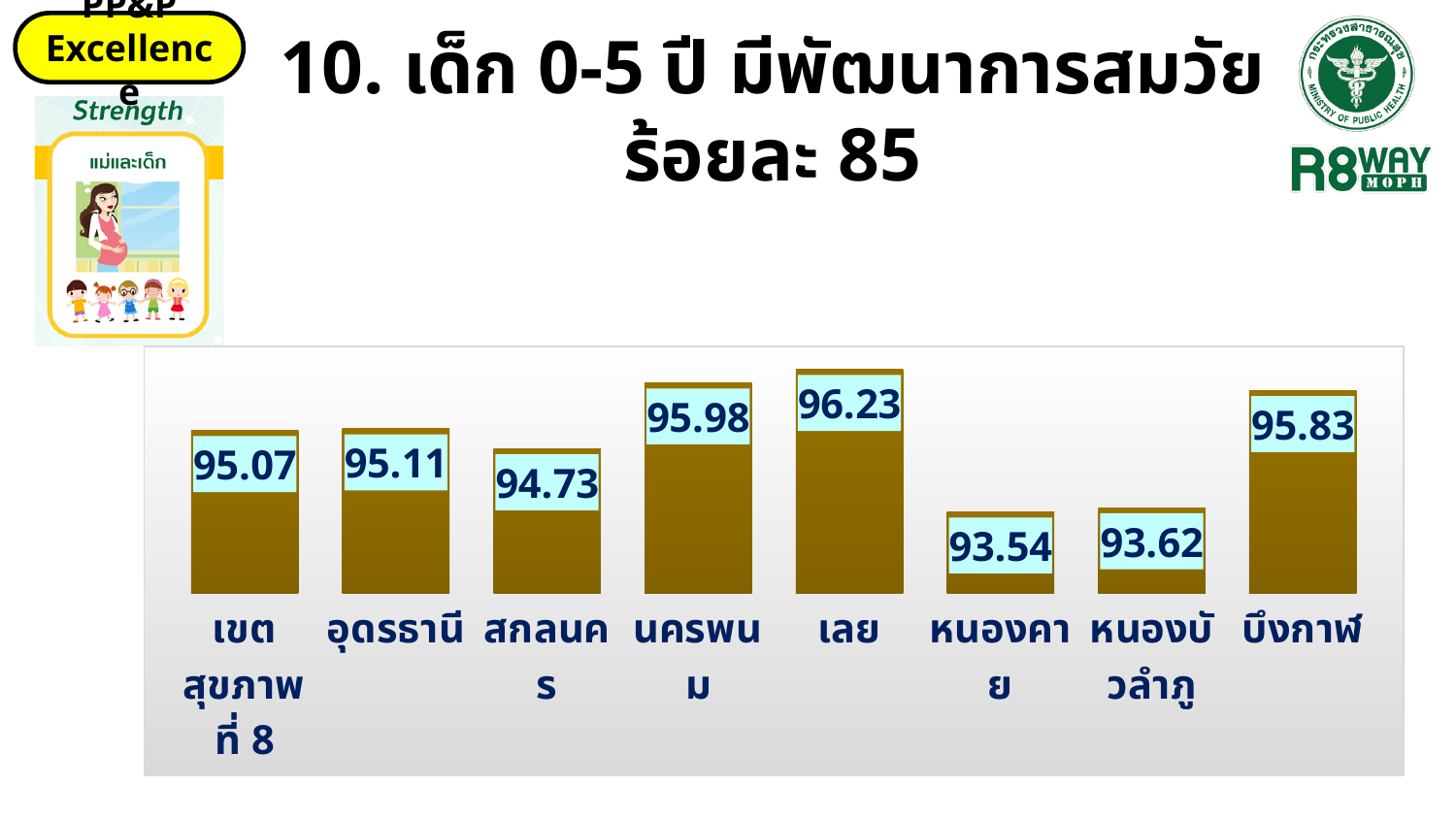
What kind of chart is shown on the slide? Bar chart Which is larger, the value for นครพนม or the value for หนองบัวลำภู? นครพนม How many categories are shown in the chart? 8 What is the difference between the values for นครพนม and สกลนคร? 1.25 Which category has the lowest value? หนองคาย What is the value for เขตสุขภาพที่ 8? 95.07 What is the value for หนองคาย? 93.54 What is the value for บึงกาฬ? 95.83 What is the difference between the values for เลย and หนองคาย? 2.69 What is the value for เลย? 96.23 What target percentage is stated in the slide title? ร้อยละ 85 Which category has the highest value? เลย